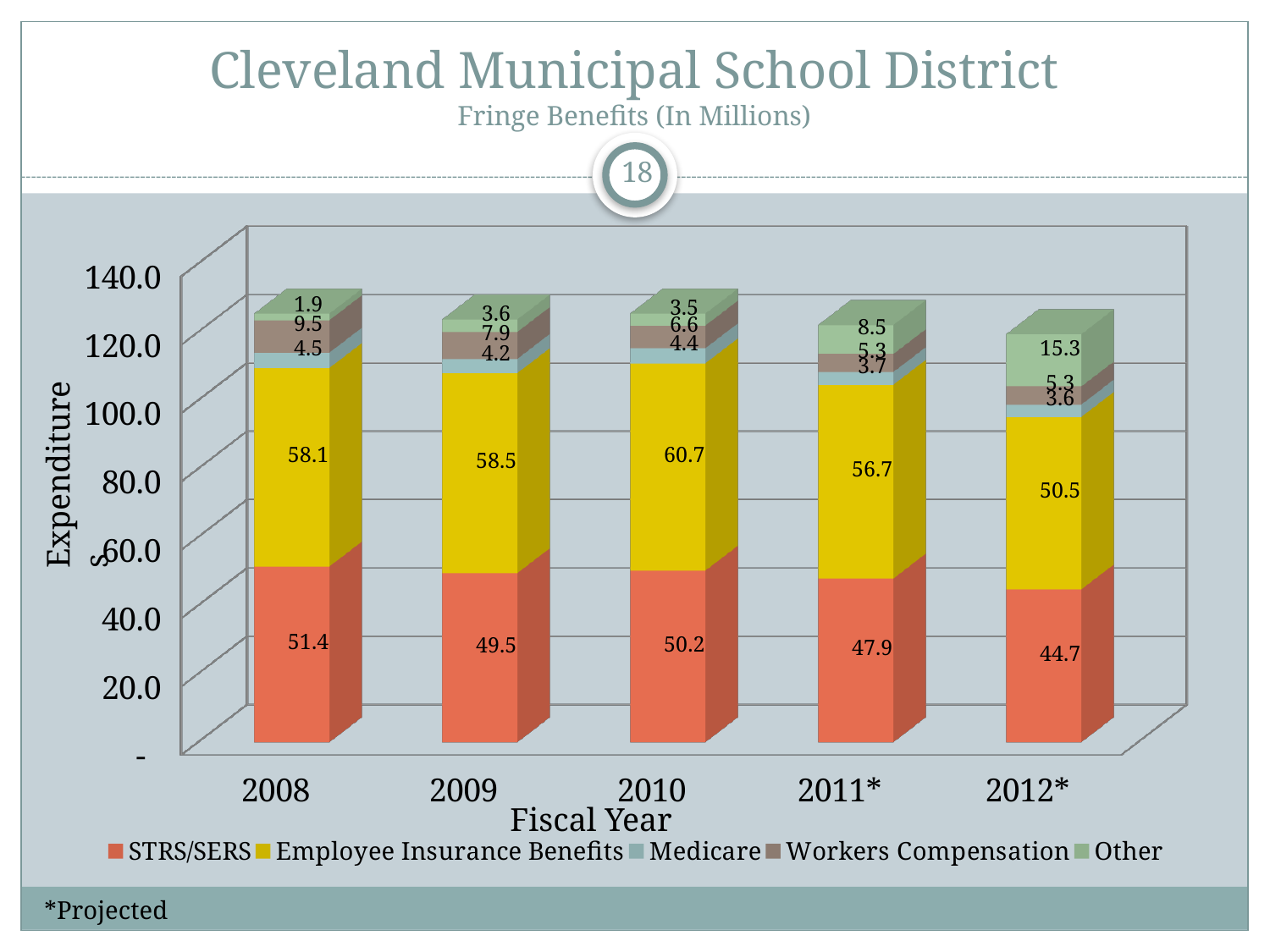
In which fiscal year is the STRS/SERS value lowest? 2012* What is the Other value for fiscal year 2012*? 15.3 How many series does the legend list? 5 What is the difference between the STRS/SERS value in 2008 and in 2012*? 6.7 In which fiscal year is the Employee Insurance Benefits value highest? 2010 In fiscal year 2011*, which is larger: Other or Workers Compensation? Other What is the Employee Insurance Benefits value for fiscal year 2010? 60.7 Does the Workers Compensation value rise or fall from 2008 to 2011*? Fall What kind of chart is shown on the slide? Stacked bar chart How many fiscal years are shown on the x axis? 5 What is the STRS/SERS value for fiscal year 2008? 51.4 What is the total of the stacked bar for fiscal year 2012*? 119.4